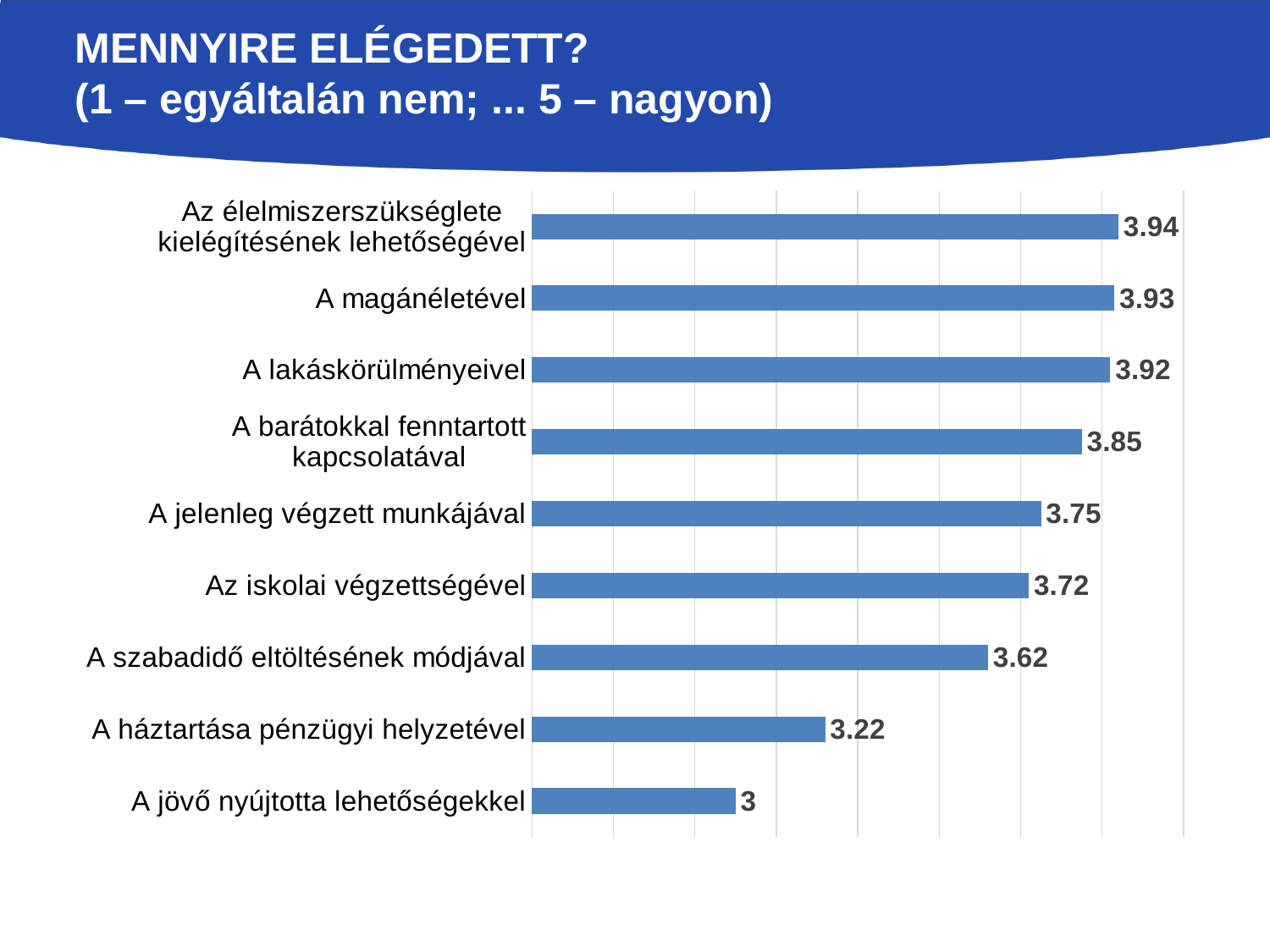
What is the title of the slide containing the chart? MENNYIRE ELÉGEDETT? (1 – egyáltalán nem; ... 5 – nagyon) What is the difference between the values for "A barátokkal fenntartott kapcsolatával" and "A háztartása pénzügyi helyzetével"? 0.63 What is the difference between the values for "Az élelmiszerszükséglete kielégítésének lehetőségével" and "A jövő nyújtotta lehetőségekkel"? 0.94 Which category has the highest value? Az élelmiszerszükséglete kielégítésének lehetőségével Which category has the lowest value? A jövő nyújtotta lehetőségekkel What is the value for "A háztartása pénzügyi helyzetével"? 3.22 What is the value for "A szabadidő eltöltésének módjával"? 3.62 How many categories are plotted in the chart? 9 What is the value for "A jelenleg végzett munkájával"? 3.75 Which is larger, the value for "Az iskolai végzettségével" or the value for "A szabadidő eltöltésének módjával"? Az iskolai végzettségével What is the value for "A magánéletével"? 3.93 What kind of chart is shown on the slide? bar chart